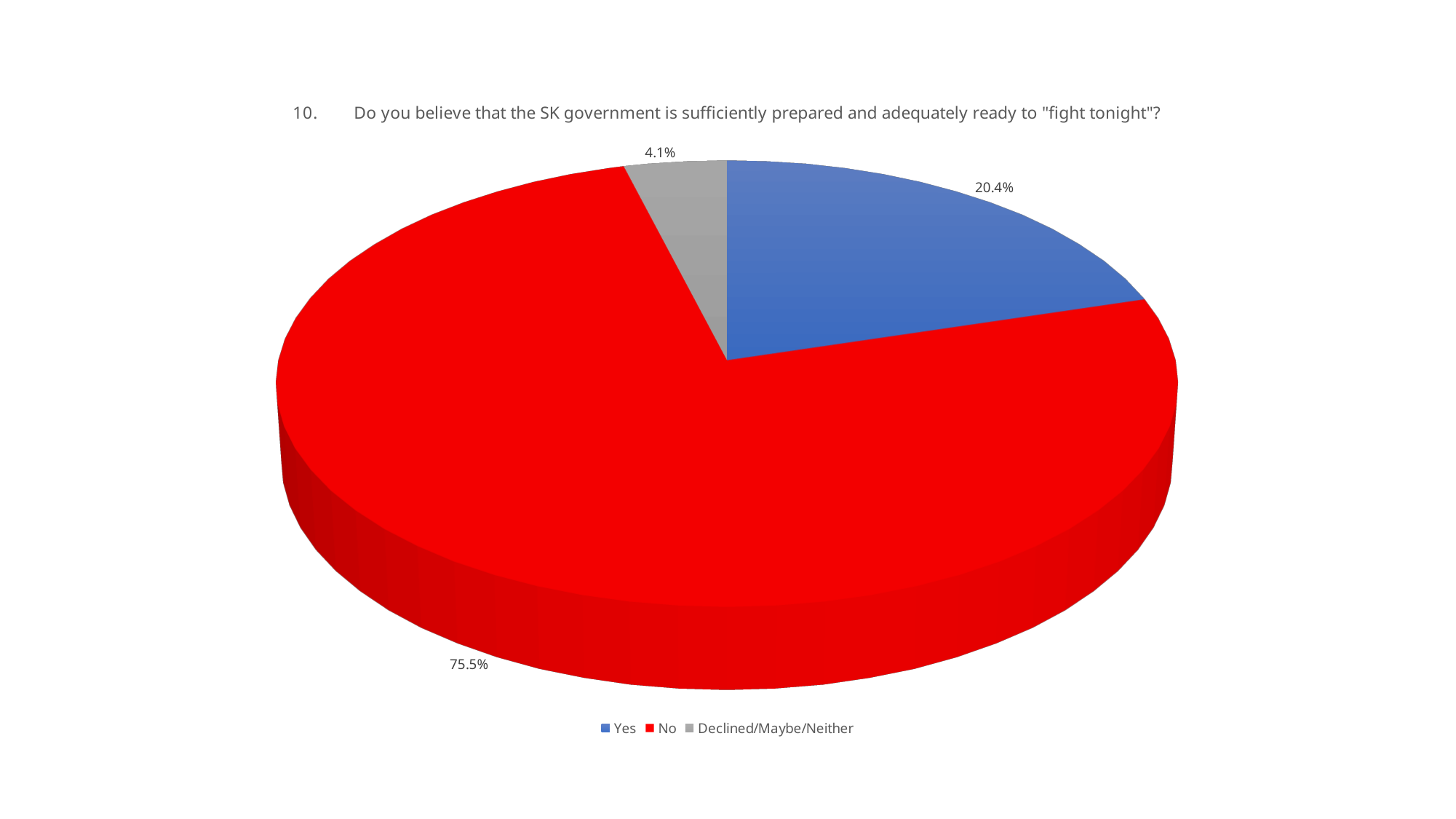
What is the difference in percentage points between the "No" and "Yes" slices? 55.1 What percentage of respondents answered "Yes"? 20.4% What percentage of respondents answered "No"? 75.5% How many entries does the legend list? 3 Which is larger, the "Yes" slice or the "Declined/Maybe/Neither" slice? Yes Which response has the smallest share of the pie? Declined/Maybe/Neither What kind of chart is shown on the slide? pie chart How many slices does the pie chart have? 3 What colour is the "No" slice? red Which response has the largest share of the pie? No What question number is shown in the chart title? 10 What percentage of respondents answered "Declined/Maybe/Neither"? 4.1%